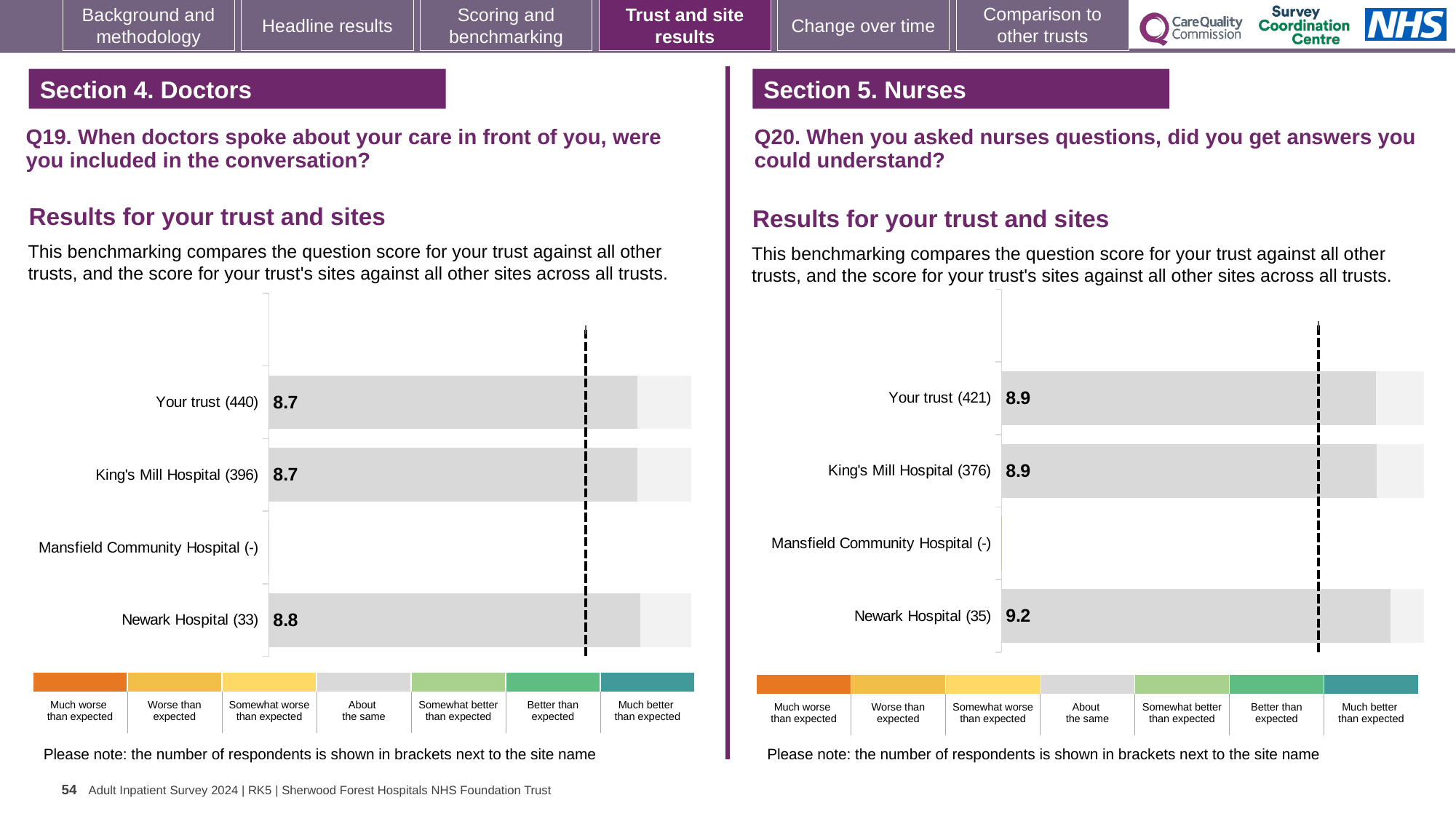
What kind of chart is used for the Q20 results on the right? bar chart In the Q20 chart on the right, what is the score for Newark Hospital? 9.2 In the Q19 chart on the left, what is the difference between the Newark Hospital score and the King's Mill Hospital score? 0.1 In the Q19 chart on the left, what is the score for Newark Hospital? 8.8 In the Q20 chart on the right, is the score for Newark Hospital larger or smaller than the score for Your trust? larger In the Q19 chart on the left, what is the score for Your trust? 8.7 In the Q20 chart on the right, what is the score for King's Mill Hospital? 8.9 In the Q20 chart on the right, what is the difference between the Newark Hospital score and the Your trust score? 0.3 In the Q19 chart on the left, which site has the highest score? Newark Hospital How many sites or rows are listed in the Q19 chart on the left? 4 In the Q20 chart on the right, which site has the highest score? Newark Hospital In the Q19 chart on the left, how many respondents are shown in brackets for Your trust? 440